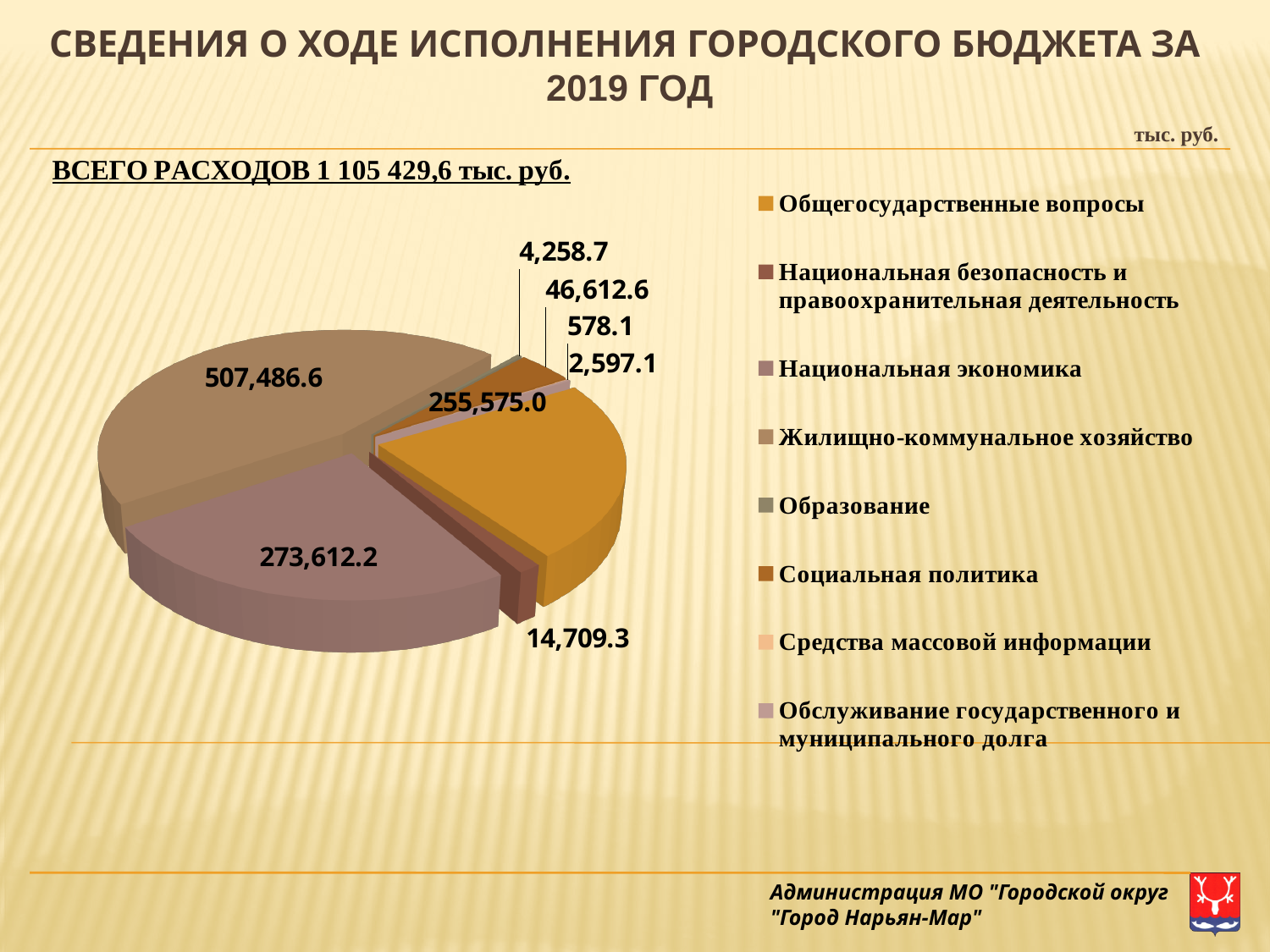
Which is larger, the value for Национальная экономика or the value for Общегосударственные вопросы? Национальная экономика What kind of chart is shown on the slide? Pie chart Which category has the largest slice of the pie? Жилищно-коммунальное хозяйство In what units are the values on the slide given? тыс. руб. What is the value for Национальная безопасность и правоохранительная деятельность? 14,709.3 What total expenditure is stated above the chart? 1 105 429,6 тыс. руб. What is the value for Общегосударственные вопросы? 255,575.0 What is the value for Жилищно-коммунальное хозяйство? 507,486.6 What is the difference between the values for Жилищно-коммунальное хозяйство and Национальная экономика? 233,874.4 What is the value for Национальная экономика? 273,612.2 How many categories does the legend list? 8 What is the smallest value labelled on the pie chart? 578.1